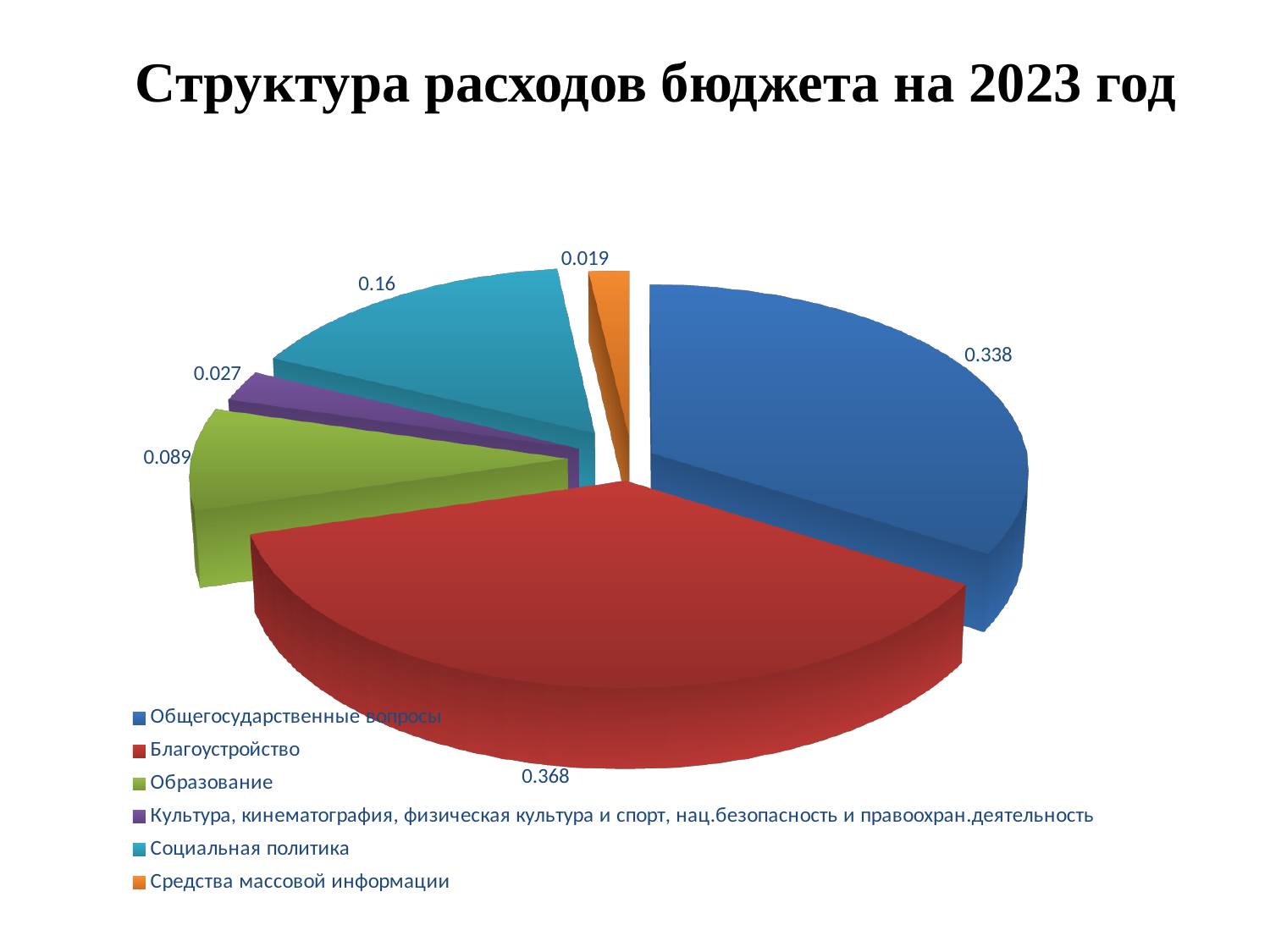
What is the difference between the values for Благоустройство and Общегосударственные вопросы? 0.03 What kind of chart is shown on the slide? Pie chart How many categories does the pie chart show? 6 Which category has the smallest slice? Средства массовой информации What is the value for Образование? 0.089 Which category has the largest slice? Благоустройство What is the value for Благоустройство? 0.368 What is the value for Общегосударственные вопросы? 0.338 What is the title of the chart? Структура расходов бюджета на 2023 год Which is larger, the value for Социальная политика or the value for Образование? Социальная политика What is the value for Средства массовой информации? 0.019 What is the value for Социальная политика? 0.16